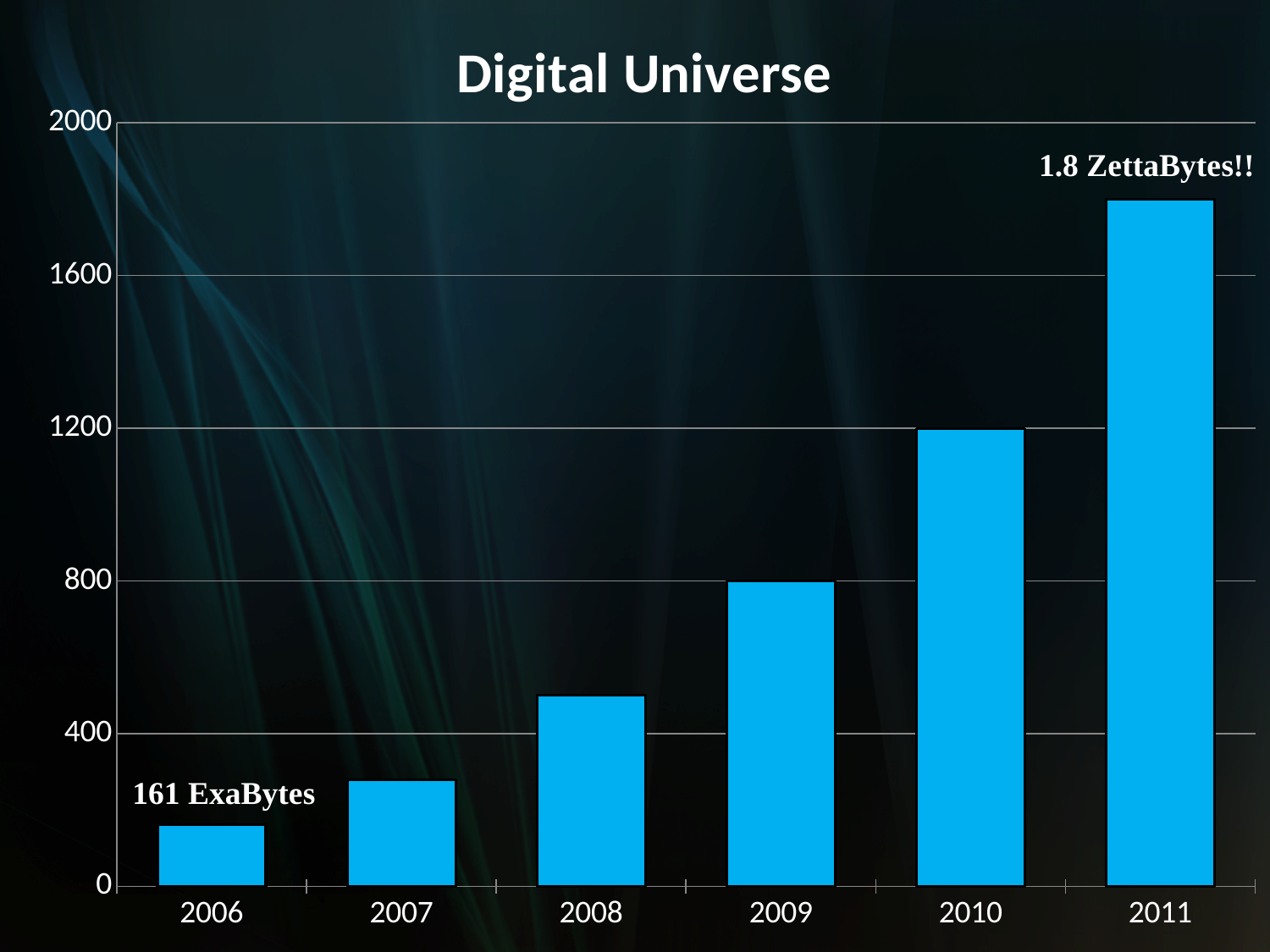
Is the value for 2008 greater or less than 400? greater Is the value for 2007 greater or less than 400? less What is the title of the chart? Digital Universe How many years are plotted on the x axis? 6 What value is labelled for 2011? 1.8 ZettaBytes Which year has the larger value, 2009 or 2008? 2009 What kind of chart is shown on the slide? bar chart What value is labelled for 2006? 161 ExaBytes Which year has the lowest bar? 2006 Is the value for 2010 greater or less than 1600? less Do the values rise or fall from 2006 to 2011? rise Which year has the highest bar? 2011